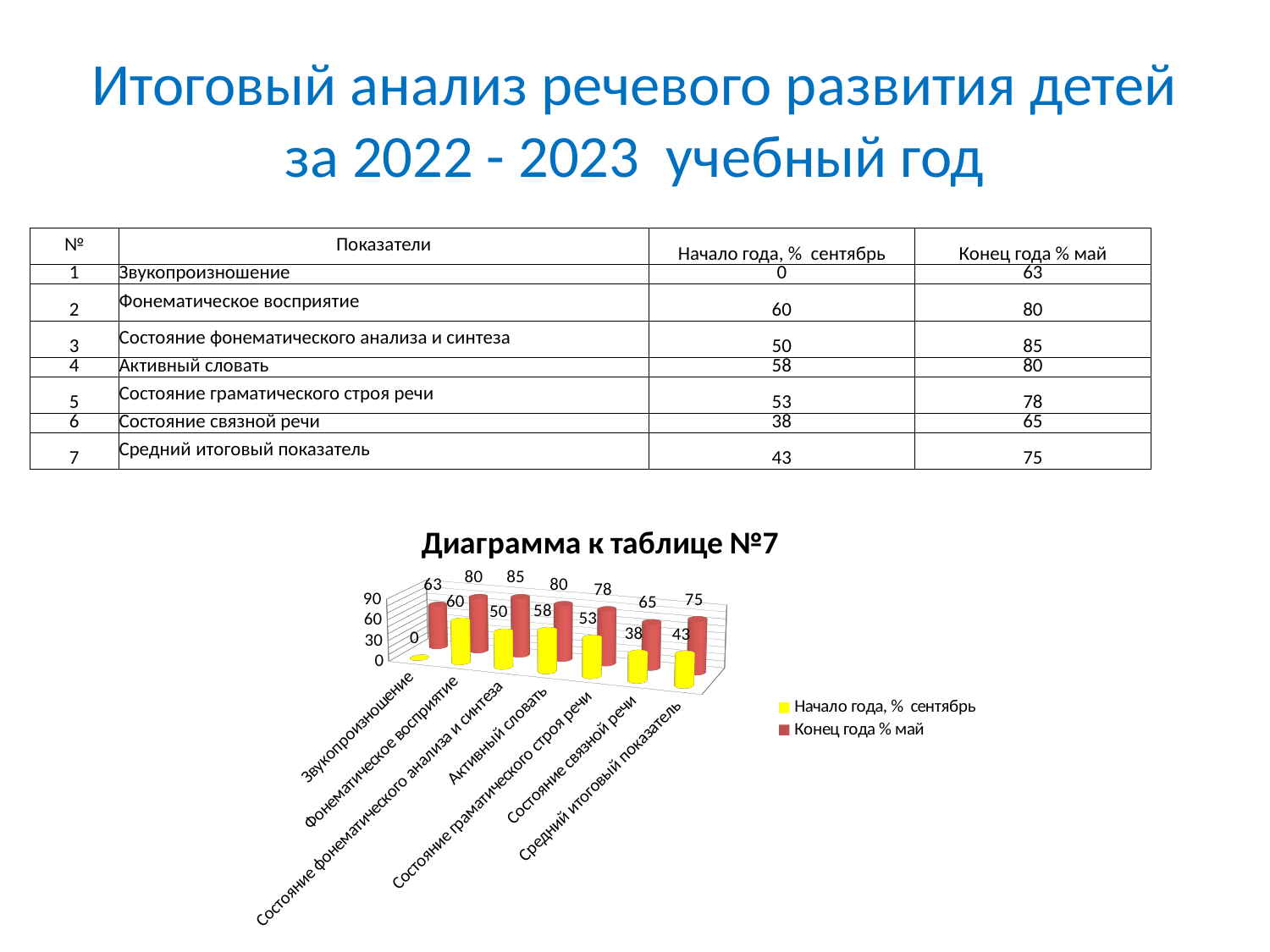
Which is larger for Активный словать: the Начало года, % сентябрь value or the Конец года % май value? Конец года % май What is the value for Звукопроизношение in the series Начало года, % сентябрь? 0 Is the value for Фонематическое восприятие in the series Начало года, % сентябрь greater or less than 30? greater What kind of chart is shown on the slide? bar chart What is the title of the chart? Диаграмма к таблице №7 What is the value for Средний итоговый показатель in the series Конец года % май? 75 Which category has the highest value in the series Конец года % май? Состояние фонематического анализа и синтеза What is the value for Состояние фонематического анализа и синтеза in the series Конец года % май? 85 What is the difference between the Конец года % май and Начало года, % сентябрь values for Состояние связной речи? 27 Which category has the lowest value in the series Начало года, % сентябрь? Звукопроизношение How many categories are shown on the x axis of the chart? 7 How many series does the chart legend list? 2